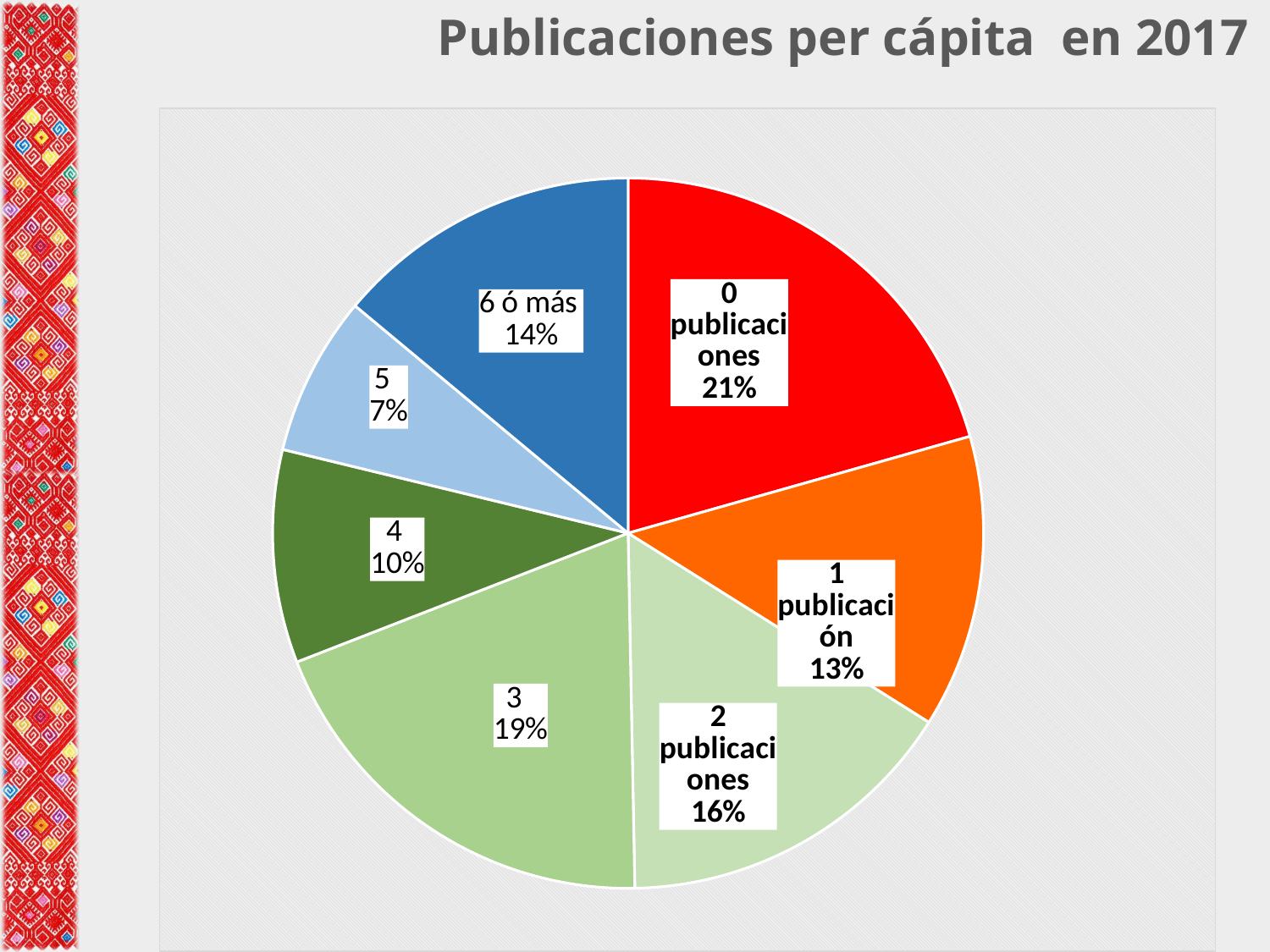
What is the difference in percentage points between the '0 publicaciones' slice and the '4' slice? 11 What percentage is shown for the '2 publicaciones' slice? 16% Which slice is larger, '2 publicaciones' or '5'? 2 publicaciones What is the title of the chart? Publicaciones per cápita en 2017 Which slice has the smallest share of the pie? 5 What percentage is shown for the '1 publicación' slice? 13% Which slice has the largest share of the pie? 0 publicaciones What share of the pie does the '0 publicaciones' slice represent? 21% How many slices does the pie chart have? 7 What percentage is shown for the slice labelled '6 ó más'? 14% What percentage is shown for the slice labelled '3'? 19% What kind of chart is shown on the slide? pie chart